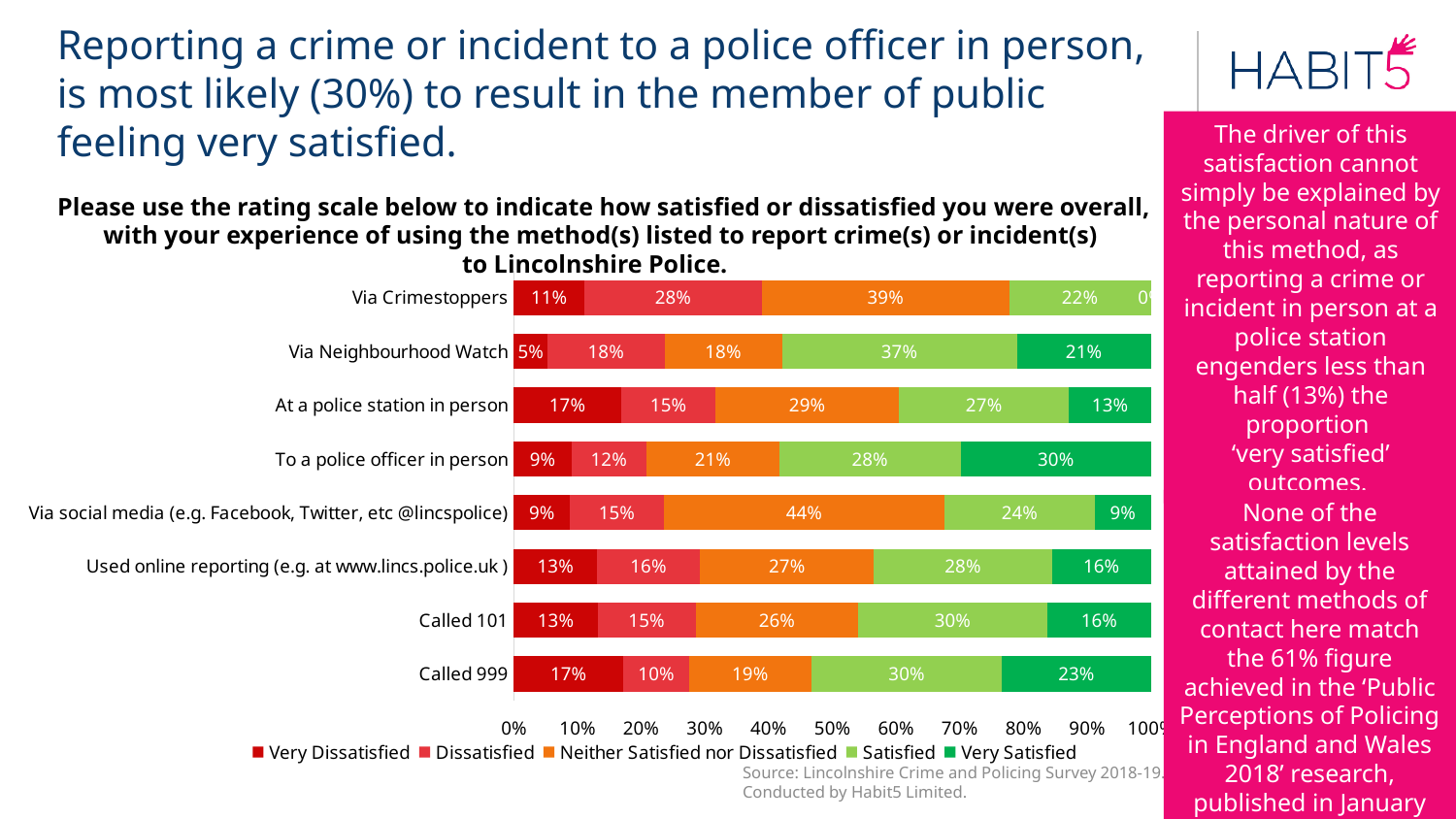
What percentage of respondents were Neither Satisfied nor Dissatisfied when reporting via social media? 44% Which reporting method has the lowest Very Dissatisfied percentage? Via Neighbourhood Watch What percentage of respondents were Very Dissatisfied with reporting via Neighbourhood Watch? 5% Which reporting method has the highest Very Satisfied percentage? To a police officer in person Which has a larger Satisfied percentage: Via Neighbourhood Watch or Via Crimestoppers? Via Neighbourhood Watch How many reporting methods (categories) are shown in the chart? 8 What is the difference between the Very Satisfied percentage for Called 999 and for Called 101? 7% Which colour represents the Very Satisfied series in the chart? Green How many series does the chart legend list? 5 What percentage of respondents who Called 999 were Satisfied? 30% What percentage of respondents were Very Satisfied when reporting to a police officer in person? 30% What kind of chart is shown on the slide? Stacked bar chart